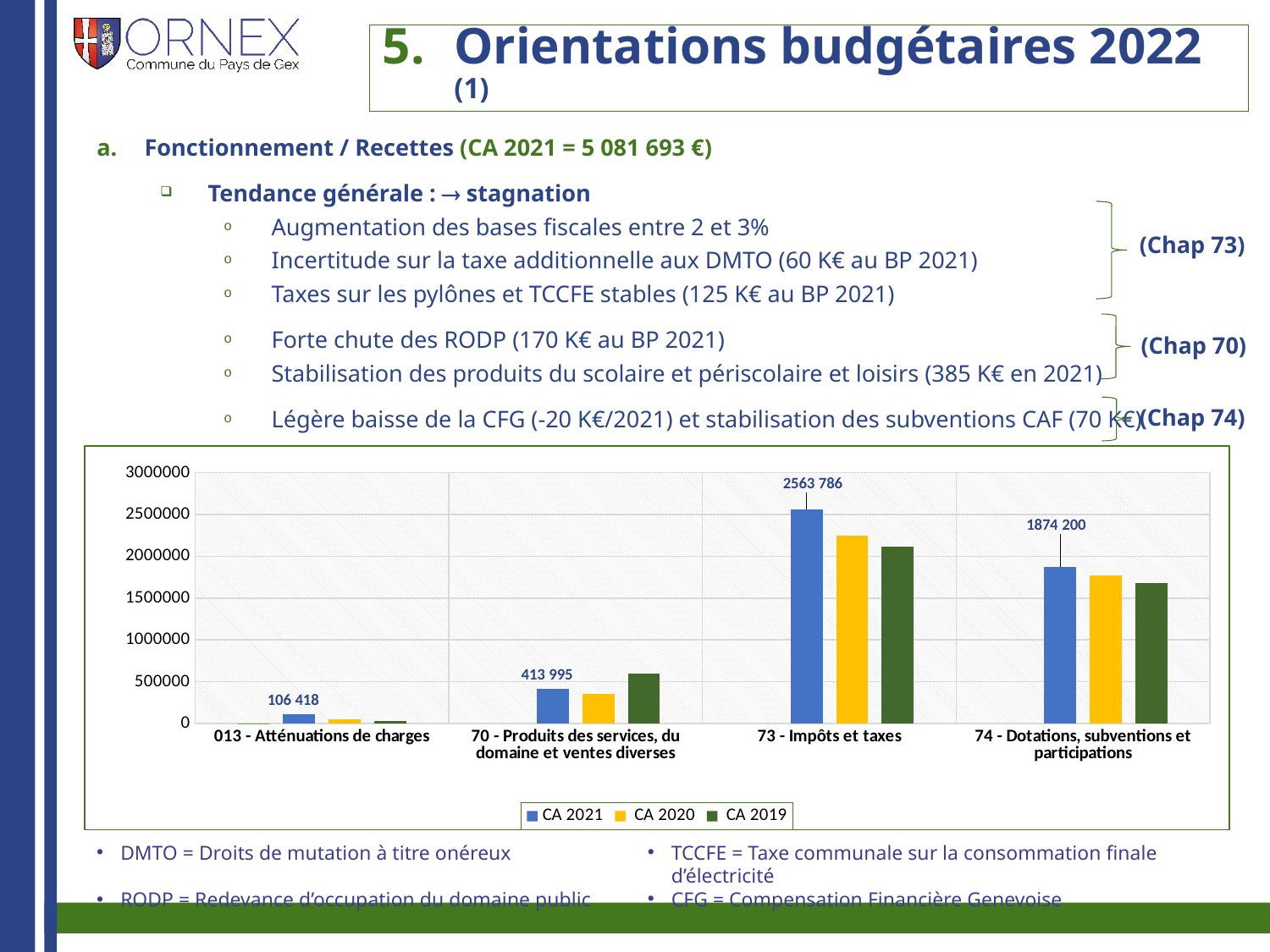
What is the difference between the CA 2021 values for 73 - Impôts et taxes and 74 - Dotations, subventions et participations? 689 586 What is the CA 2021 value for 74 - Dotations, subventions et participations? 1874 200 Which category has the lowest CA 2021 value? 013 - Atténuations de charges Is the CA 2019 value for 74 - Dotations, subventions et participations greater or less than 2000000? less How many categories are shown on the x axis of the chart? 4 Which category has the highest CA 2021 value? 73 - Impôts et taxes Is the CA 2020 value for 73 - Impôts et taxes greater or less than 2000000? greater What is the CA 2021 value for 73 - Impôts et taxes? 2563 786 What is the CA 2021 value for 70 - Produits des services, du domaine et ventes diverses? 413 995 What is the CA 2021 value for 013 - Atténuations de charges? 106 418 For 70 - Produits des services, du domaine et ventes diverses, which is larger: CA 2021 or CA 2019? CA 2019 How many series does the chart legend list? 3